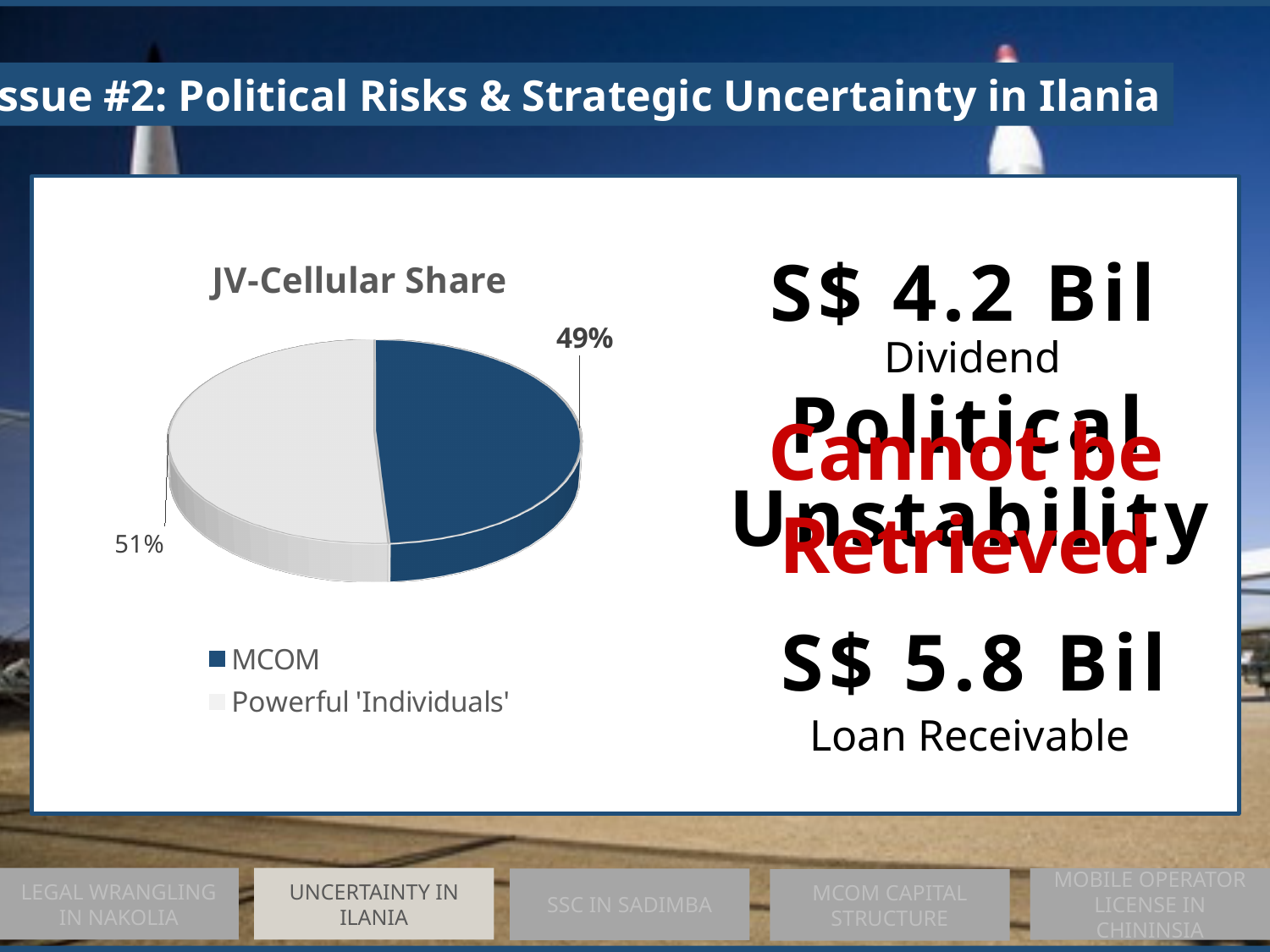
Which legend entry is shown in dark blue? MCOM What is the difference in percentage points between the Powerful 'Individuals' slice and the MCOM slice? 2 percentage points Which is larger, the MCOM slice or the Powerful 'Individuals' slice? Powerful 'Individuals' Which slice of the pie is the smallest? MCOM What share of the pie do Powerful 'Individuals' hold? 51% What share of the pie does MCOM hold? 49% How many slices does the pie chart have? 2 What is the title of the chart on the slide? JV-Cellular Share How many entries does the chart legend list? 2 Which slice of the pie is the largest? Powerful 'Individuals' What kind of chart is shown on the slide? pie chart